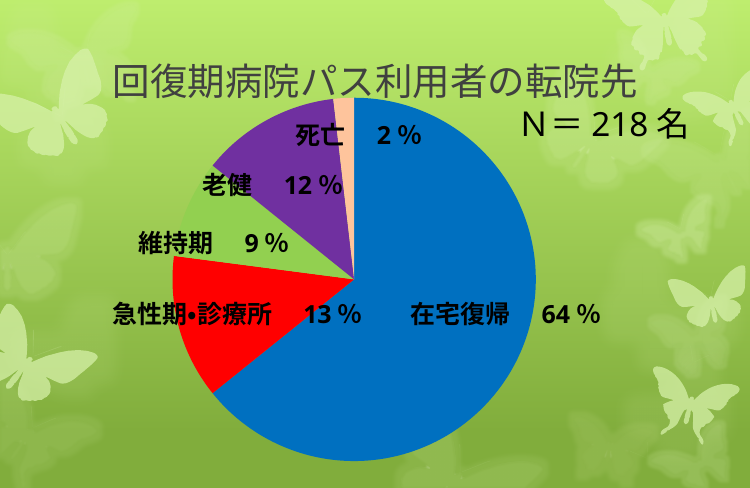
Which category has the smallest share of the pie? 死亡 What type of chart is shown on the slide? pie chart What percentage of the pie is 急性期•診療所? 13％ Which category has the largest share of the pie? 在宅復帰 How many slices does the pie chart have? 5 What percentage of the pie is 維持期? 9％ What is the title of the chart? 回復期病院パス利用者の転院先 What percentage of the pie is 在宅復帰? 64％ What percentage of the pie is 老健? 12％ Which is larger, the share for 急性期•診療所 or the share for 維持期? 急性期•診療所 What percentage of the pie is 死亡? 2％ What is the difference in percentage points between 在宅復帰 and 急性期•診療所? 51